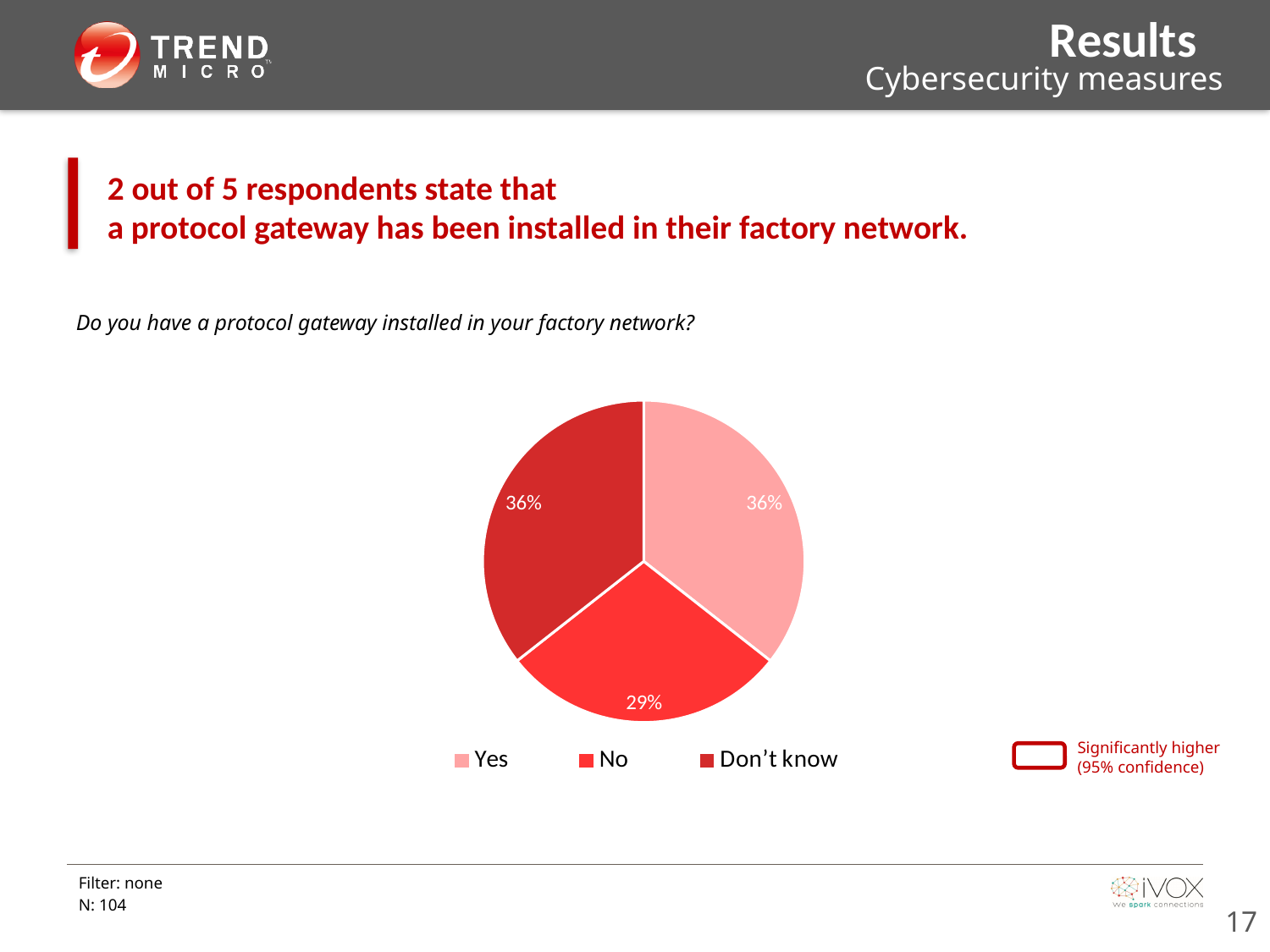
How many response categories are shown in the pie chart? 3 What kind of chart is used to show the responses? Pie chart What percentage of respondents answered "No"? 29% What are the three entries listed in the chart legend? Yes, No, Don't know By how many percentage points does the "Don't know" share exceed the "No" share? 7 percentage points Which response has the smallest share of the pie? No Which is larger, the share for "Yes" or the share for "No"? Yes What percentage of respondents answered "Don't know"? 36% What is the survey question shown above the chart? Do you have a protocol gateway installed in your factory network? By how many percentage points does the "Yes" share exceed the "No" share? 7 percentage points What share of the pie does the "Don't know" slice represent? 36% What percentage of respondents answered "Yes" to having a protocol gateway installed in their factory network? 36%